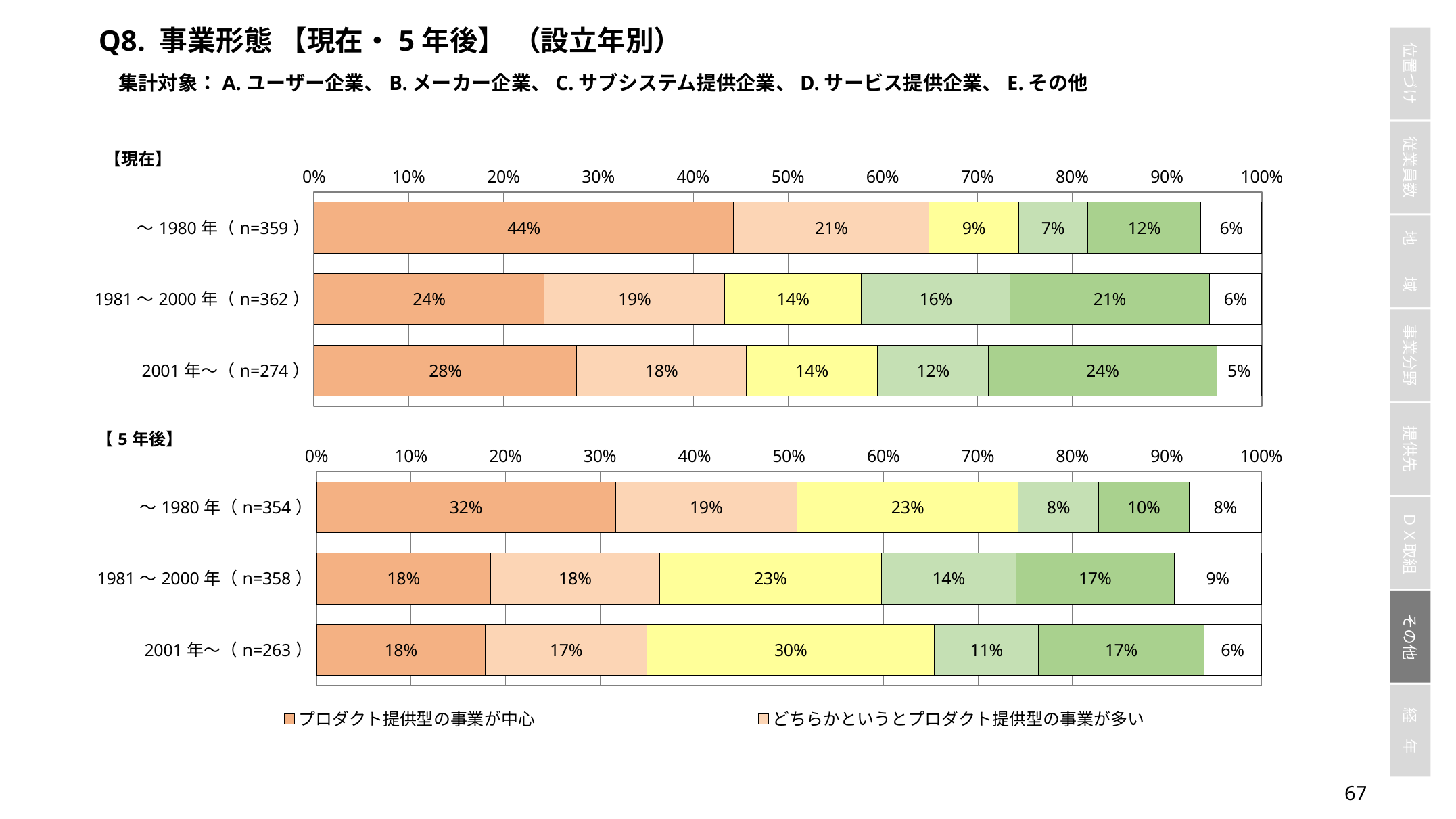
In the 【現在】 chart, what is the difference between the プロダクト提供型の事業が中心 values for ～1980年 and 2001年～? 16 percentage points In the 【現在】 chart, what is the value of the yellow segment for 1981～2000年 (n=362)? 14% In the 【5年後】 chart, what is the value of どちらかというとプロダクト提供型の事業が多い for 2001年～ (n=263)? 17% In the 【現在】 chart, which category has the highest value for プロダクト提供型の事業が中心? ～1980年 (n=359) In the 【現在】 chart, which category has the lowest value for プロダクト提供型の事業が中心? 1981～2000年 (n=362) In the 【5年後】 chart, what is the sample size (n) shown for 1981～2000年? n=358 What kind of chart is the 【5年後】 chart? Stacked bar chart In the 【現在】 chart, what is the value of プロダクト提供型の事業が中心 for ～1980年 (n=359)? 44% Which legend entry corresponds to the dark orange segments? プロダクト提供型の事業が中心 How many categories (bars) does the 【現在】 chart show? 3 In the 【5年後】 chart, which is larger for どちらかというとプロダクト提供型の事業が多い: ～1980年 or 1981～2000年? ～1980年 What is the difference between the プロダクト提供型の事業が中心 value for ～1980年 in the 【現在】 chart and in the 【5年後】 chart? 12 percentage points